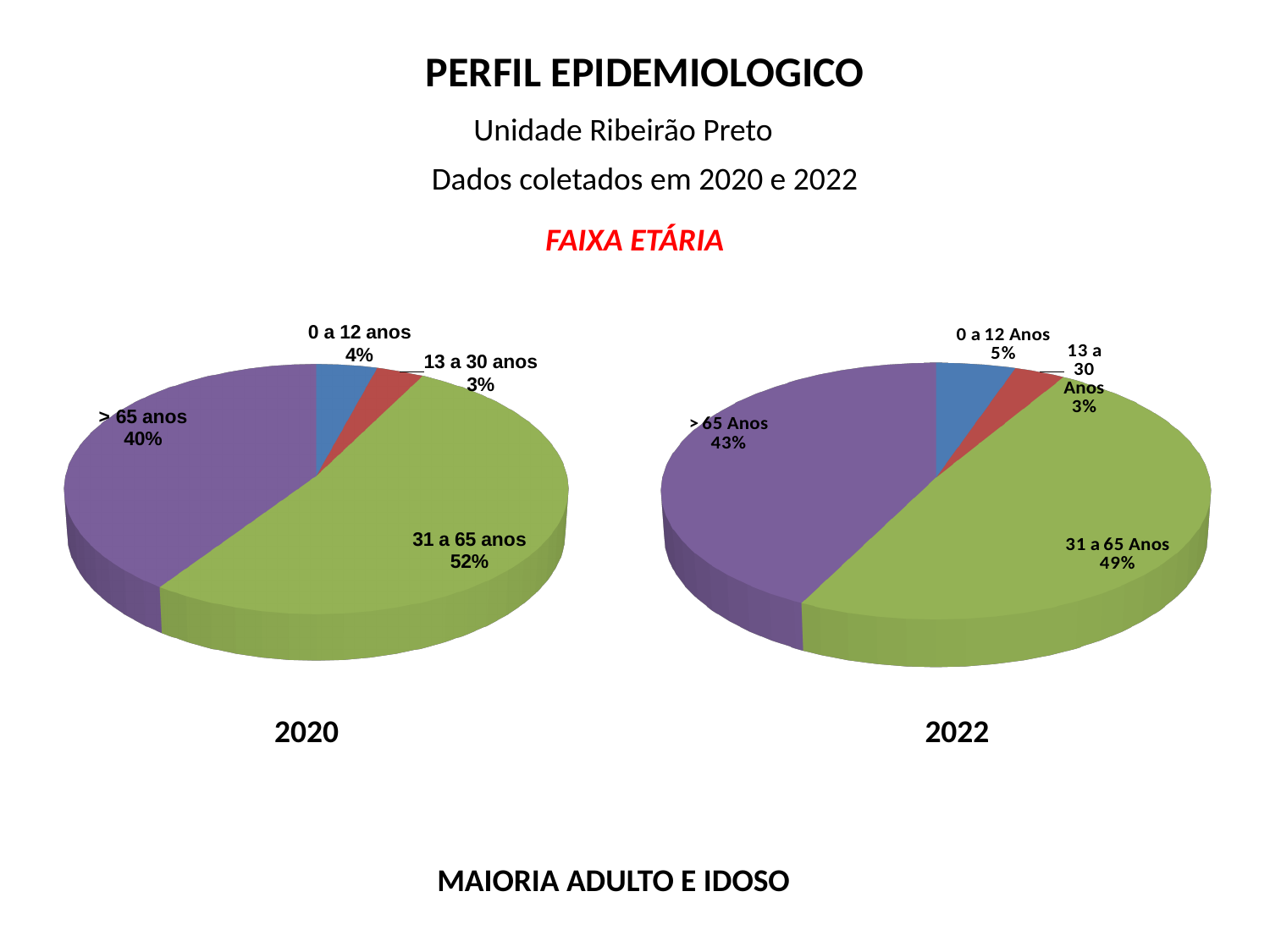
In the 2022 pie chart, what is the combined share of 31 a 65 Anos and > 65 Anos? 92% In the 2020 pie chart, what is the difference between the shares for 31 a 65 anos and > 65 anos? 12% In the 2020 pie chart, which age group has the largest share? 31 a 65 anos In the 2020 pie chart, what share is shown for 31 a 65 anos? 52% What colour is the 31 a 65 anos slice in the 2020 pie chart? Green How many slices does the 2020 pie chart have? 4 In the 2020 pie chart, what share is shown for 0 a 12 anos? 4% In the 2022 pie chart, what share is shown for 13 a 30 Anos? 3% In the 2022 pie chart, which age group has the smallest share? 13 a 30 Anos What type of chart is used for the 2022 data? Pie chart In the 2022 pie chart, what share is shown for > 65 Anos? 43% In the 2022 pie chart, which is larger: the share for 0 a 12 Anos or the share for 13 a 30 Anos? 0 a 12 Anos